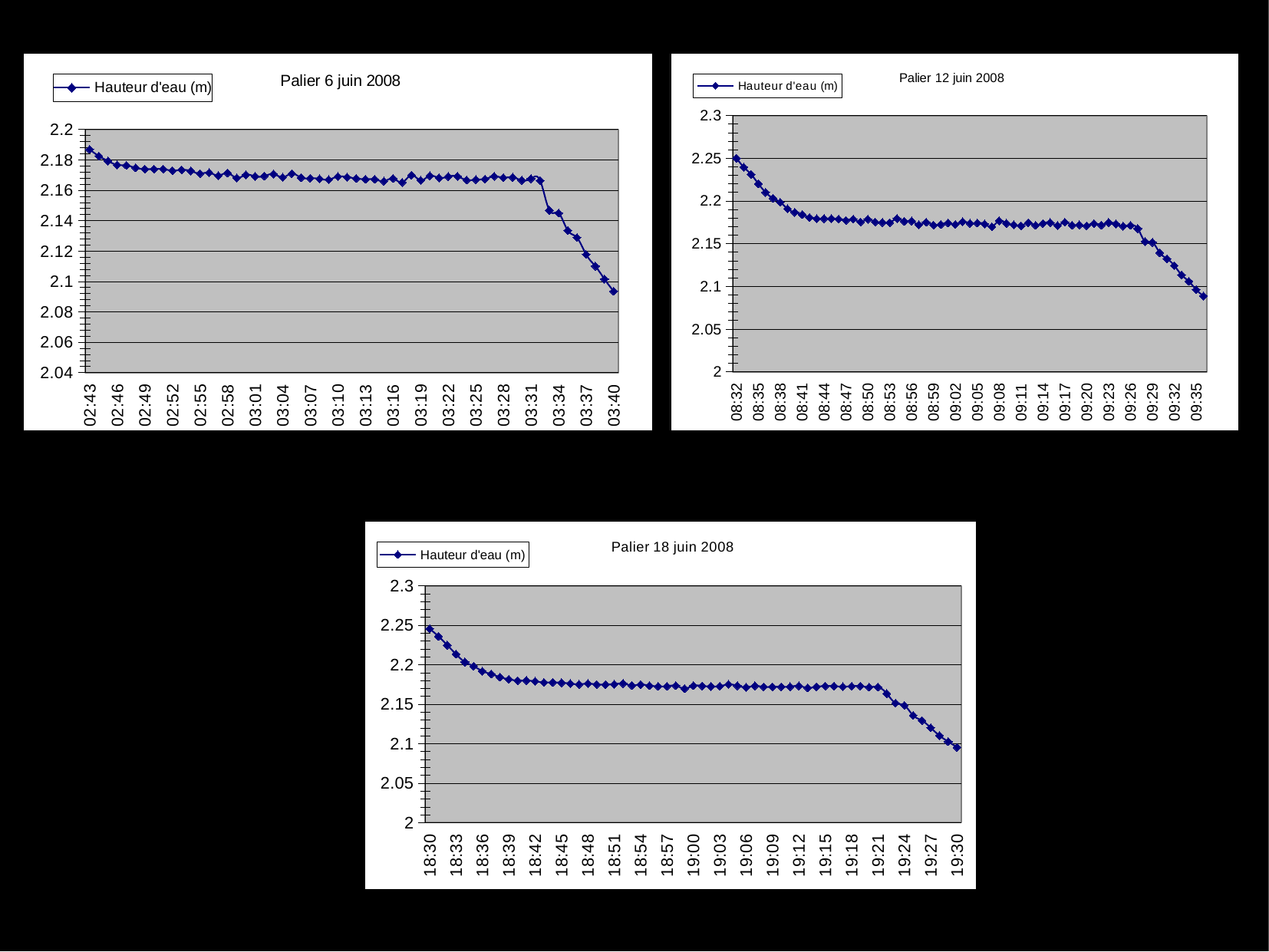
In the 'Palier 12 juin 2008' chart, is the value at 08:32 greater or less than 2.2? greater In the 'Palier 6 juin 2008' chart, which is larger, the value at 02:43 or the value at 03:40? 02:43 In the 'Palier 18 juin 2008' chart, is the value at 19:30 greater or less than 2.15? less How many series does the legend of the 'Palier 12 juin 2008' chart list? 1 What kind of chart is the 'Palier 6 juin 2008' chart? line chart In the 'Palier 6 juin 2008' chart, do the values overall rise or fall from 02:43 to 03:40? fall In the 'Palier 6 juin 2008' chart, is the value at 03:40 greater or less than 2.12? less What is the title of the chart at the bottom of the slide? Palier 18 juin 2008 What is the name of the series shown in the legend of the 'Palier 18 juin 2008' chart? Hauteur d'eau (m) In the 'Palier 18 juin 2008' chart, which is larger, the value at 18:30 or the value at 19:00? 18:30